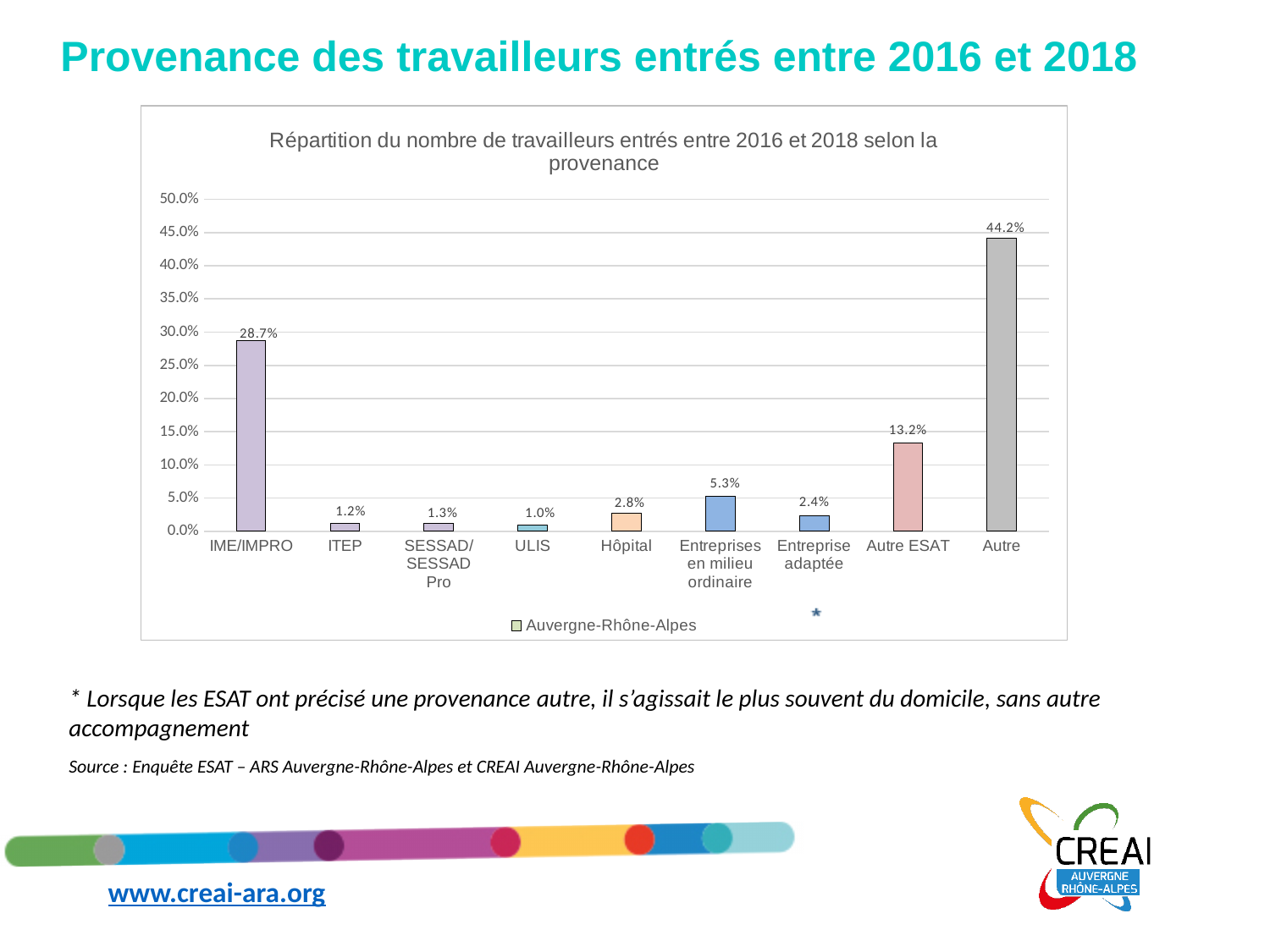
Is the value for Autre ESAT greater or less than 10.0%? greater What kind of chart is shown? bar chart What is the difference between the values for Autre and IME/IMPRO? 15.5% How many categories are shown on the x axis? 9 Which category has the lowest value? ULIS What is the value for Autre ESAT? 13.2% How many series does the legend list? 1 Which category has the highest value? Autre What is the value for IME/IMPRO? 28.7% Which is larger, the value for Hôpital or the value for Entreprise adaptée? Hôpital What is the value for Entreprises en milieu ordinaire? 5.3% What is the legend entry of the chart? Auvergne-Rhône-Alpes